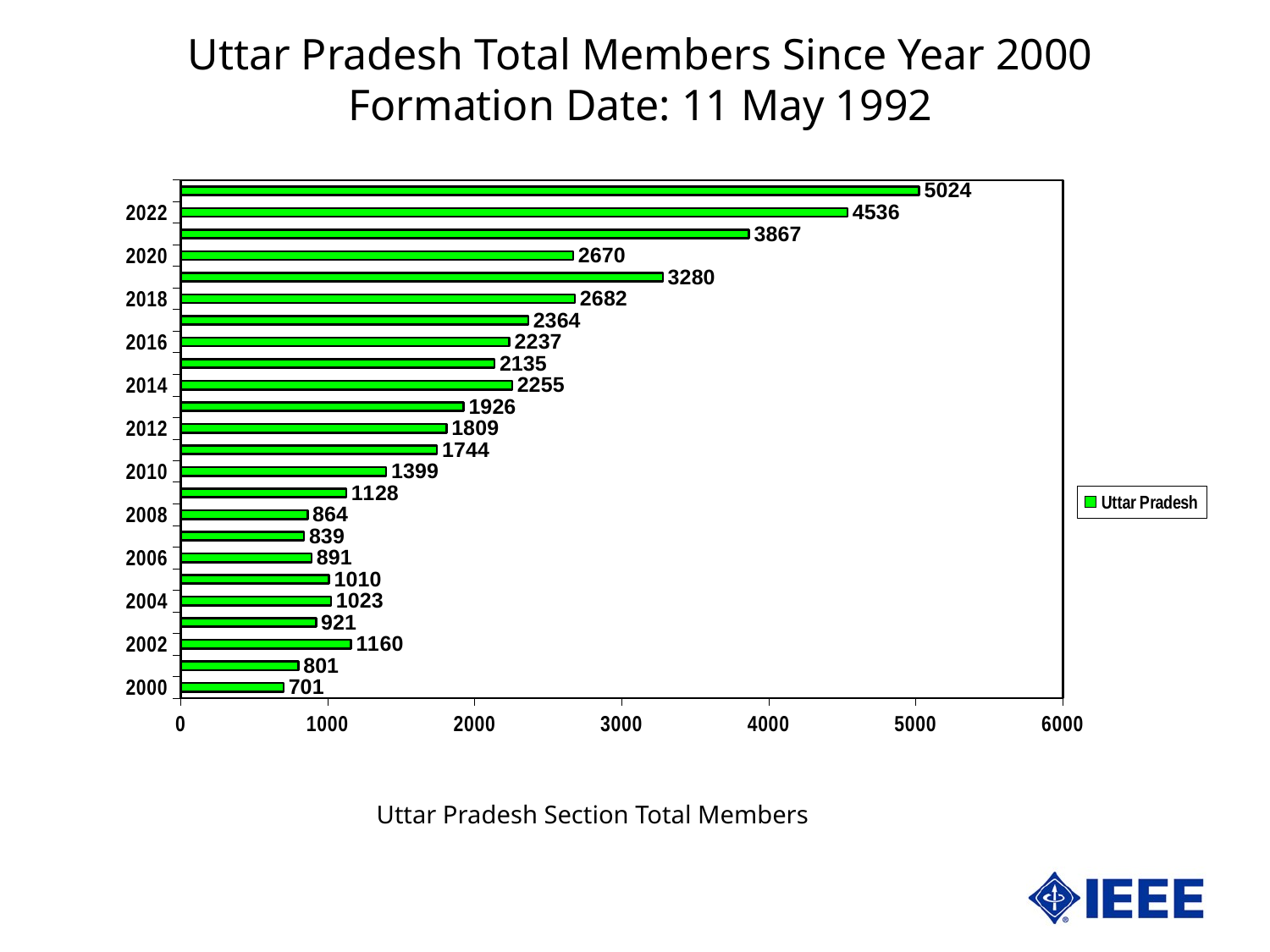
What is the difference between the values for 2022 and 2020? 1866 What is the value for Uttar Pradesh in 2022? 4536 Which is larger, the value for 2014 or the value for 2018? 2018 How many bars are plotted on the chart? 24 What is the value for Uttar Pradesh in 2016? 2237 What is the value for Uttar Pradesh in 2010? 1399 What type of chart is shown on the slide? bar chart Which year has the lowest value on the chart? 2000 What is the value for Uttar Pradesh in 2000? 701 Which year has the highest value on the chart? 2023 How many series does the legend list? 1 What is the name of the series shown in the legend? Uttar Pradesh